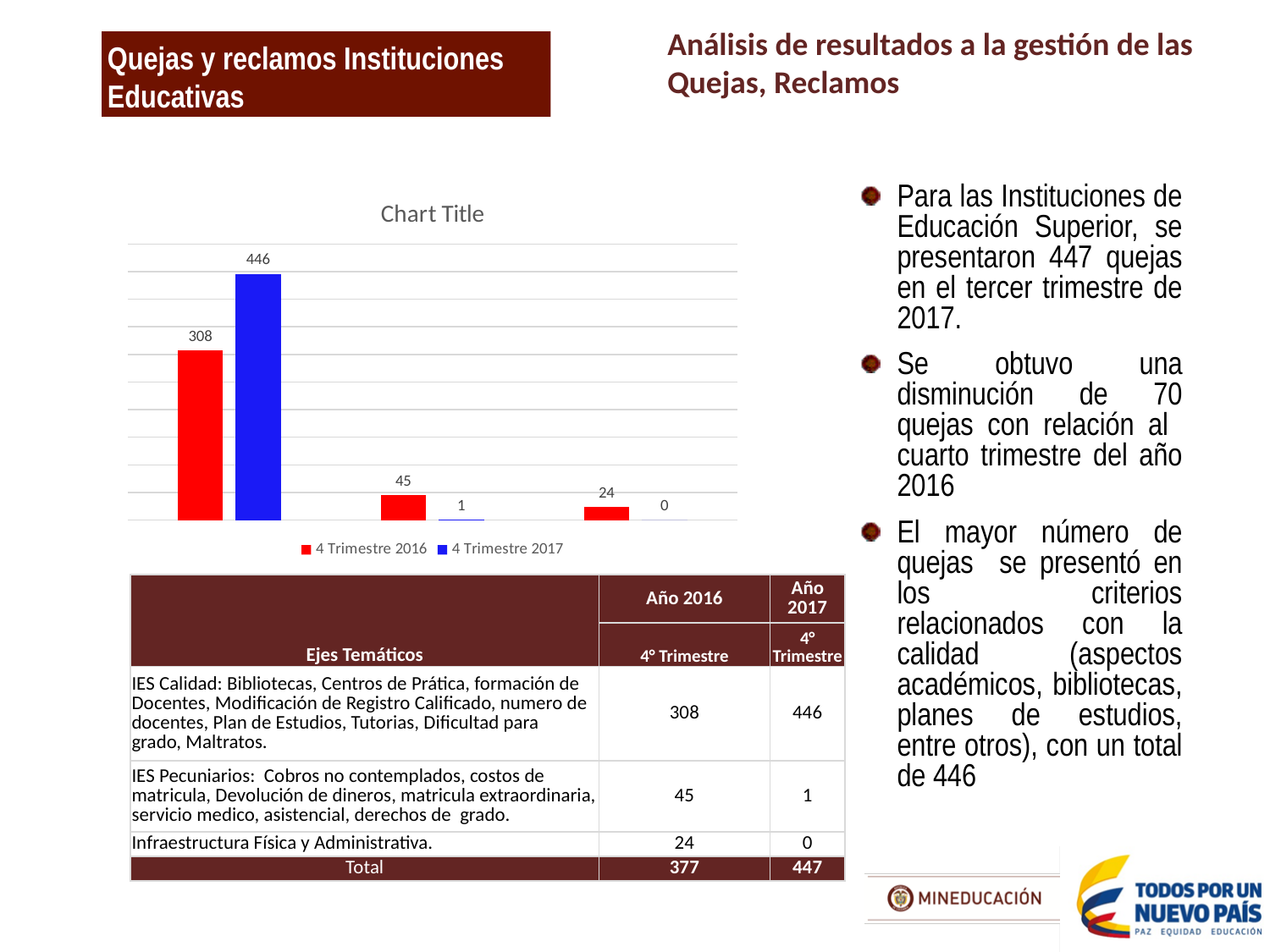
What is the difference between the 4 Trimestre 2017 and 4 Trimestre 2016 bars in the first group of the chart? 138 In the second (middle) group of the chart, which series has the larger value, 4 Trimestre 2016 or 4 Trimestre 2017? 4 Trimestre 2016 What are the two series named in the chart legend? 4 Trimestre 2016 and 4 Trimestre 2017 What is the value of the 4 Trimestre 2017 bar in the third (rightmost) group of the chart? 0 Which bar in the chart has the highest value? 4 Trimestre 2017 in the first group (446) How many series does the chart legend list? 2 How many groups of bars are plotted in the chart? 3 What colour are the 4 Trimestre 2017 bars in the chart? blue What is the value of the 4 Trimestre 2016 bar in the second (middle) group of the chart? 45 What is the value of the 4 Trimestre 2017 bar in the first (leftmost) group of the chart? 446 What is the value of the 4 Trimestre 2016 bar in the first (leftmost) group of the chart? 308 What type of chart is shown on the slide? bar chart